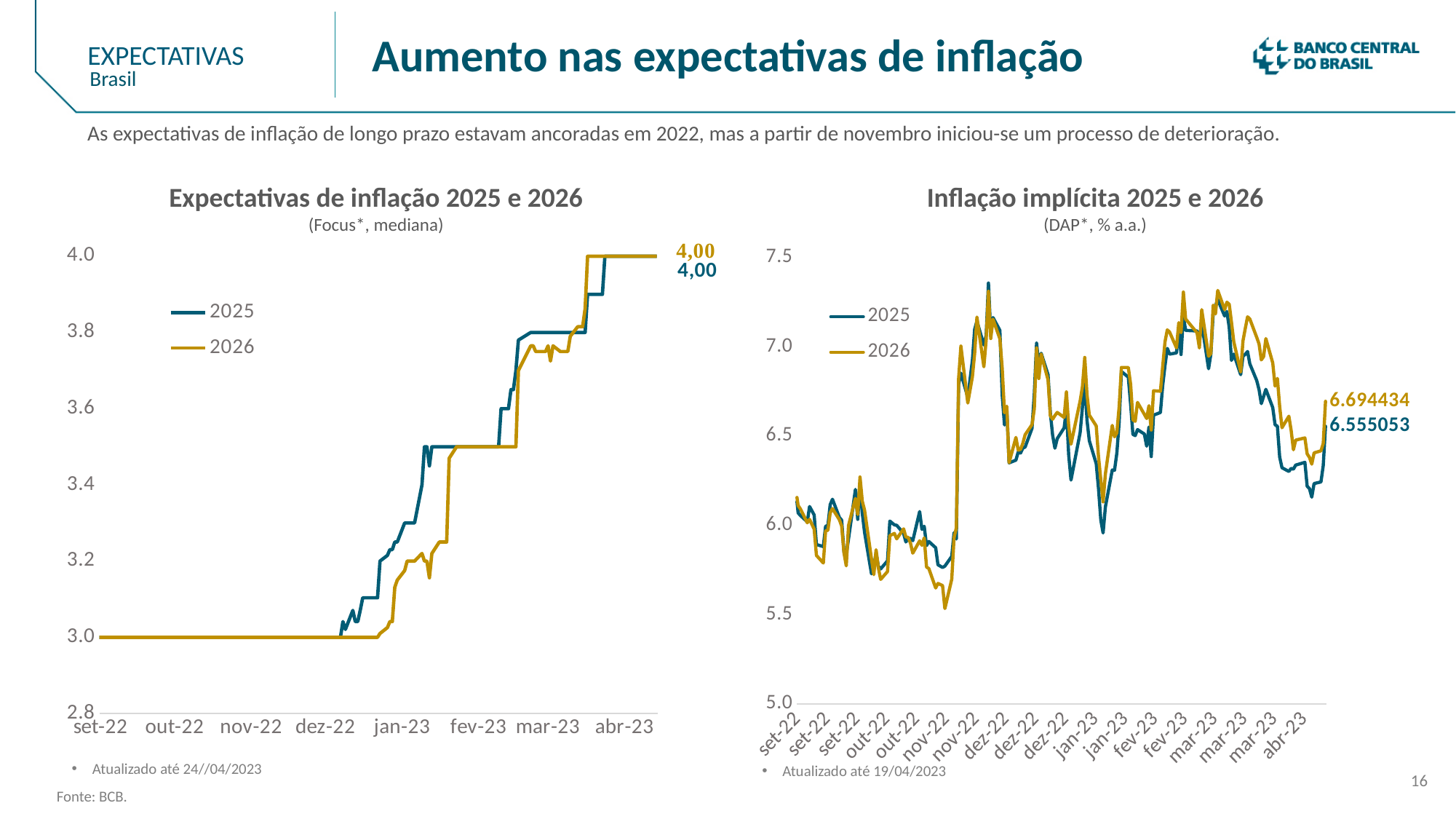
In the left chart, 'Expectativas de inflação 2025 e 2026', what is the final labelled value of the 2025 series? 4,00 In the right chart, 'Inflação implícita 2025 e 2026', which series has the higher final labelled value, 2025 or 2026? 2026 How many series does the legend of the right chart, 'Inflação implícita 2025 e 2026', list? 2 What kind of chart is the left chart, 'Expectativas de inflação 2025 e 2026'? line chart In the left chart, 'Expectativas de inflação 2025 e 2026', is the value of the 2025 series in dez-22 greater or less than 3.4? less In the left chart, 'Expectativas de inflação 2025 e 2026', what is the final labelled value of the 2026 series? 4,00 In the right chart, 'Inflação implícita 2025 e 2026', is the lowest value of the 2026 series around nov-22 greater or less than 6.0? less In the right chart, 'Inflação implícita 2025 e 2026', what is the final labelled value of the 2025 series? 6.555053 In the right chart, 'Inflação implícita 2025 e 2026', what is the difference between the final labelled values of the 2026 and 2025 series? 0.139381 In the right chart, 'Inflação implícita 2025 e 2026', what is the final labelled value of the 2026 series? 6.694434 What is the subtitle shown under the title of the right chart, 'Inflação implícita 2025 e 2026'? (DAP*, % a.a.) In the left chart, 'Expectativas de inflação 2025 e 2026', do the values generally rise or fall from set-22 to abr-23? rise